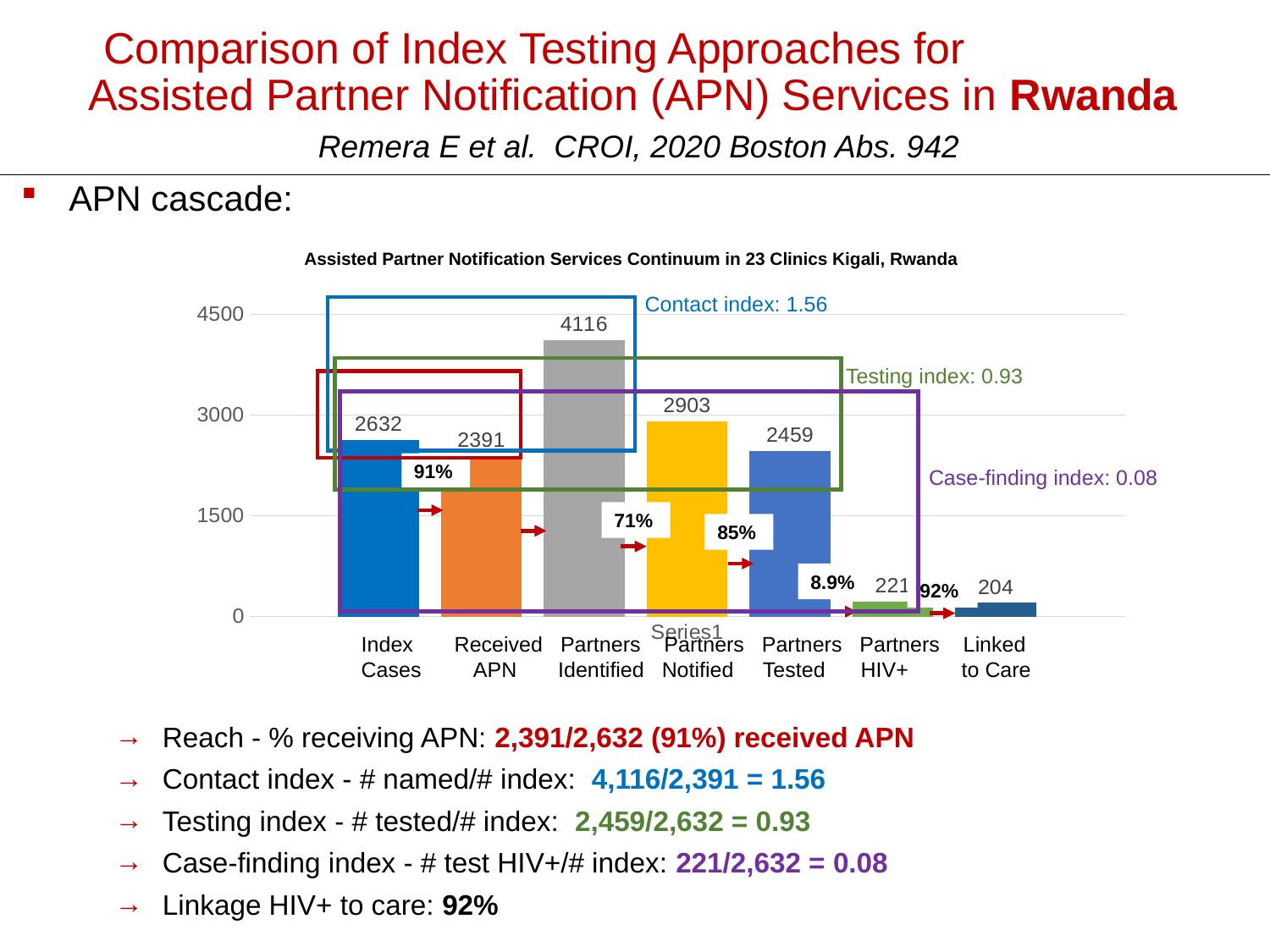
What is the value for Partners Identified? 4116 Is the value for Partners Identified greater or less than 3000? greater What is the difference between Index Cases and Received APN? 241 What kind of chart is shown? Bar chart Which category has the highest value? Partners Identified What is the value for Partners HIV+? 221 Which is larger, Partners Notified or Partners Tested? Partners Notified Which category has the lowest value? Linked to Care What is the title of the chart? Assisted Partner Notification Services Continuum in 23 Clinics Kigali, Rwanda What is the difference between Partners Notified and Partners Tested? 444 How many categories are shown on the x axis? 7 What is the value for Index Cases? 2632